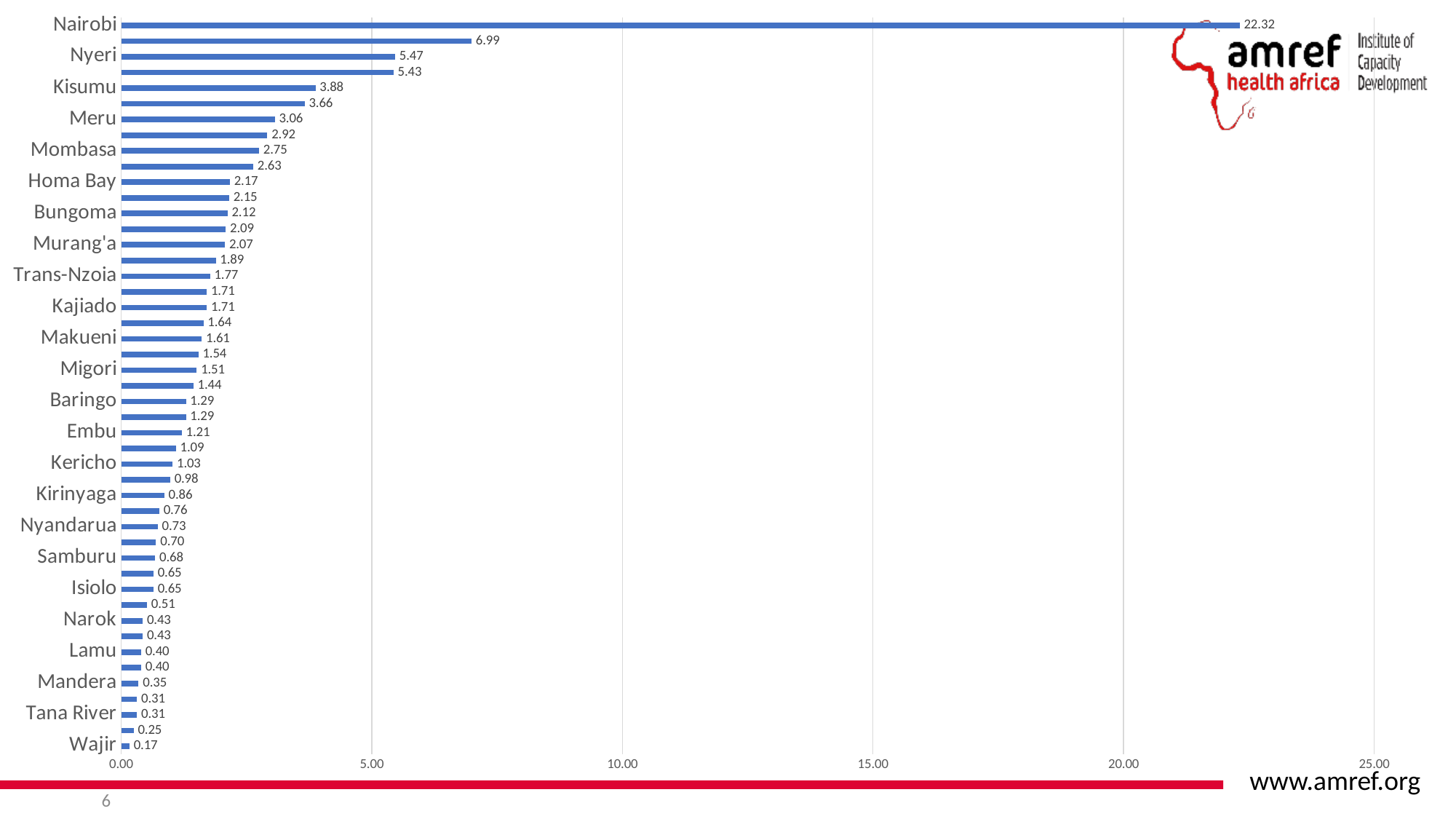
What is the value for Wajir? 0.17 What is the difference between the values for Kisumu and Meru? 0.82 What is the value for Nairobi? 22.32 What is the value for Kisumu? 3.88 Which county has the lowest value? Wajir Which county has the highest value? Nairobi What is the difference between the values for Nairobi and Nyeri? 16.85 How many bars are plotted in the chart? 47 What kind of chart is shown on the slide? Bar chart What is the value for Homa Bay? 2.17 Is the value for Nairobi greater or less than 20.00? greater Which has a larger value, Meru or Mombasa? Meru